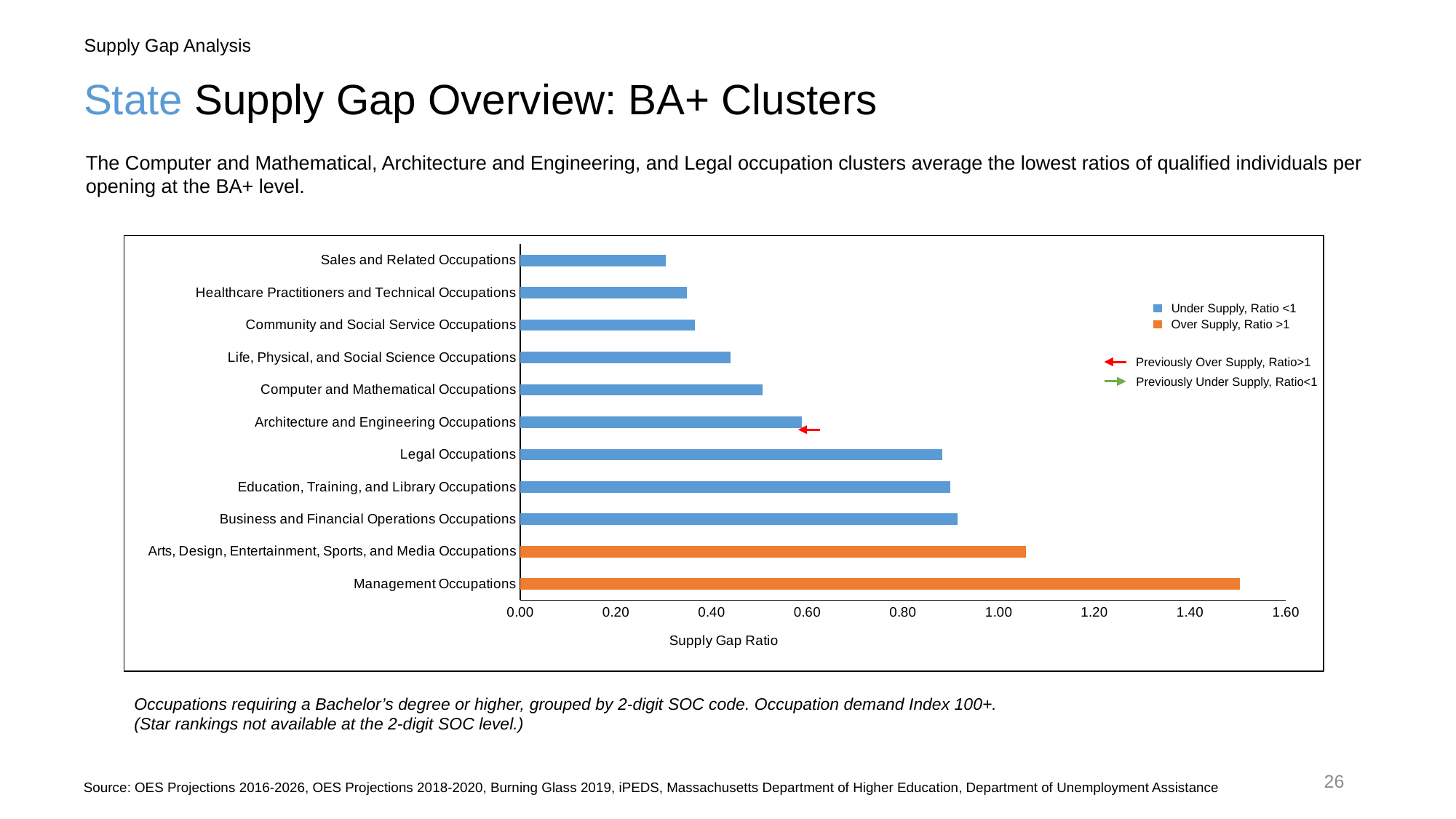
Which occupation cluster is marked with a red arrow indicating it was previously over supply? Architecture and Engineering Occupations Which occupation cluster has the highest supply gap ratio? Management Occupations Is the supply gap ratio for Life, Physical, and Social Science Occupations greater or less than 0.60? less Is the supply gap ratio for Legal Occupations greater or less than 0.80? greater Which has a larger supply gap ratio: Management Occupations or Arts, Design, Entertainment, Sports, and Media Occupations? Management Occupations What kind of chart is shown on the slide? bar chart Is the supply gap ratio for Sales and Related Occupations greater or less than 0.40? less Which occupation cluster has the lowest supply gap ratio? Sales and Related Occupations Which has a larger supply gap ratio: Legal Occupations or Computer and Mathematical Occupations? Legal Occupations What is the title of the horizontal axis of the chart? Supply Gap Ratio How many occupation clusters are plotted in the chart? 11